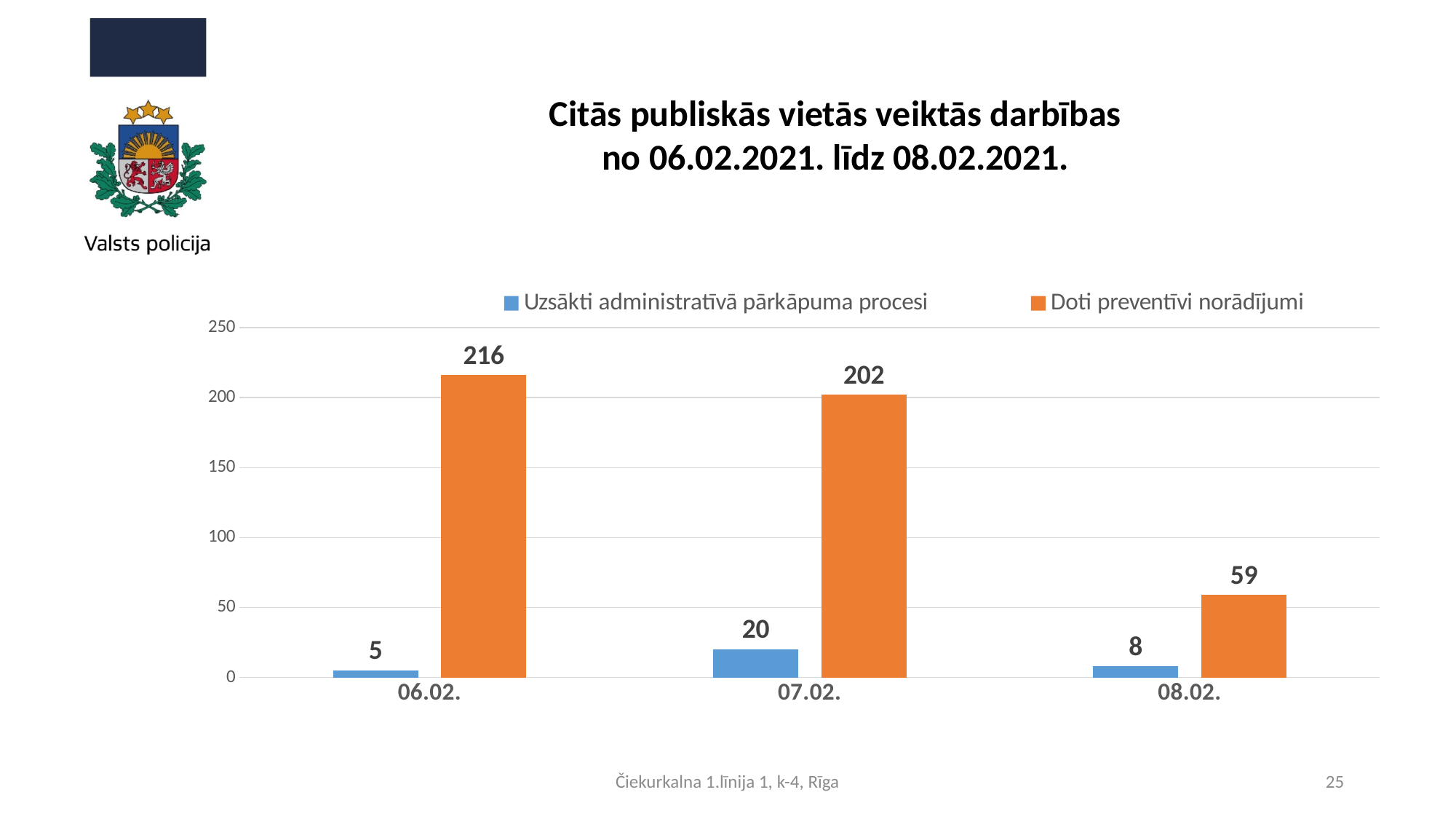
Is the value for "Doti preventīvi norādījumi" on 07.02. greater or less than 150? greater On which date is "Doti preventīvi norādījumi" highest? 06.02. What is the value of "Uzsākti administratīvā pārkāpuma procesi" on 07.02.? 20 How many dates are shown on the x axis? 3 On which date is "Uzsākti administratīvā pārkāpuma procesi" lowest? 06.02. What kind of chart is shown on the slide? bar chart Which colour represents "Doti preventīvi norādījumi" in the chart? orange What is the value of "Doti preventīvi norādījumi" on 06.02.? 216 Which is larger: "Uzsākti administratīvā pārkāpuma procesi" on 07.02. or on 08.02.? 07.02. What is the difference between "Doti preventīvi norādījumi" on 06.02. and on 07.02.? 14 How many series does the legend list? 2 What is the value of "Doti preventīvi norādījumi" on 08.02.? 59